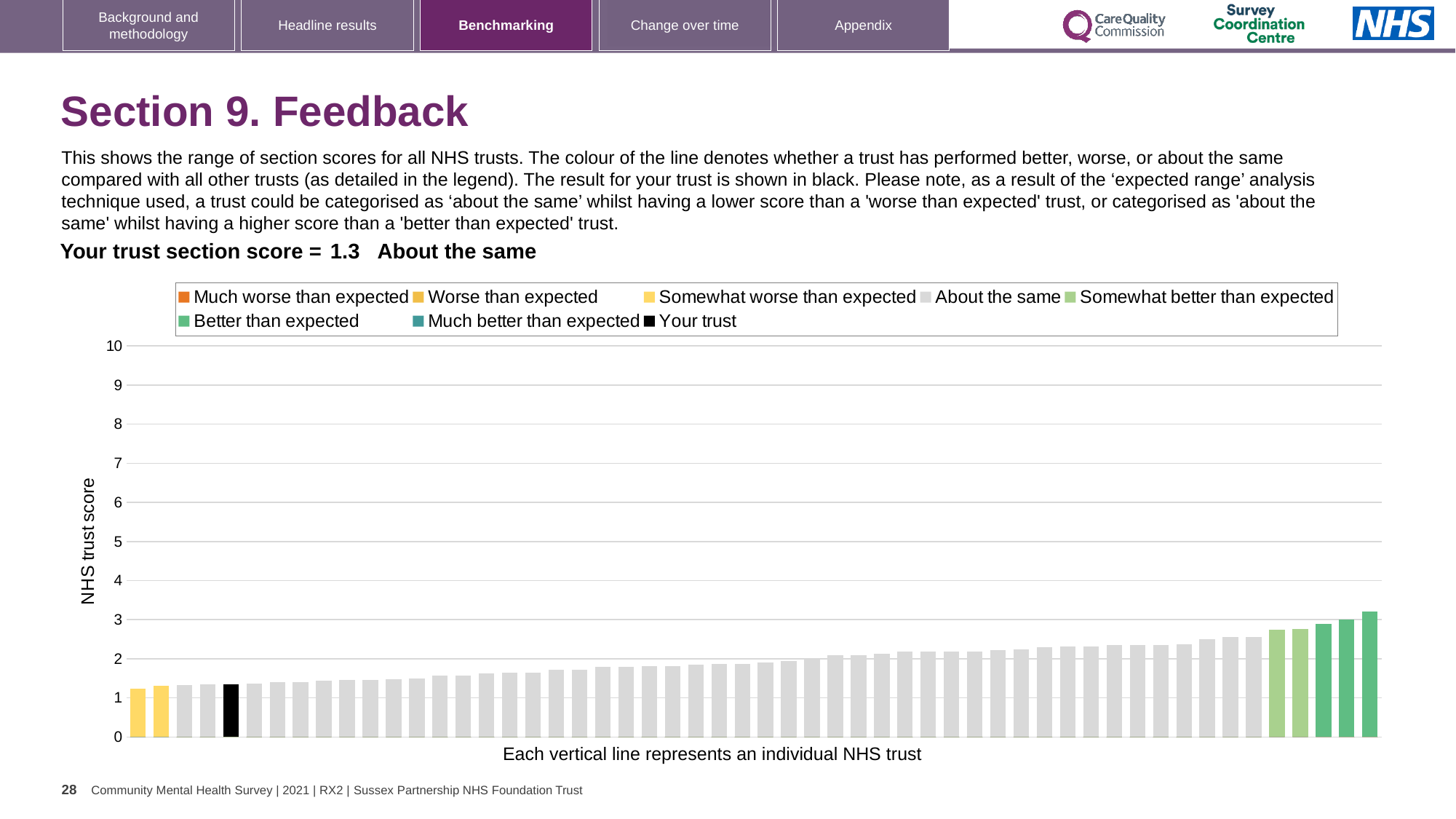
Which performance category does the highest-scoring trust belong to? Better than expected Do the bar values rise or fall from left to right along the x axis? rise Is the value for your trust (the black bar) greater or less than 2? less Which performance category is your trust placed in for Section 9. Feedback? About the same How many entries does the chart legend list? 8 What is the label on the y axis of the chart? NHS trust score What kind of chart is shown on the slide? bar chart How many bars are coloured as 'Somewhat worse than expected'? 2 Which performance category does the lowest-scoring trust belong to? Somewhat worse than expected What is the section score for your trust shown on the slide? 1.3 Is the value of the tallest bar greater or less than 4? less Is the value of the shortest bar greater or less than 2? less